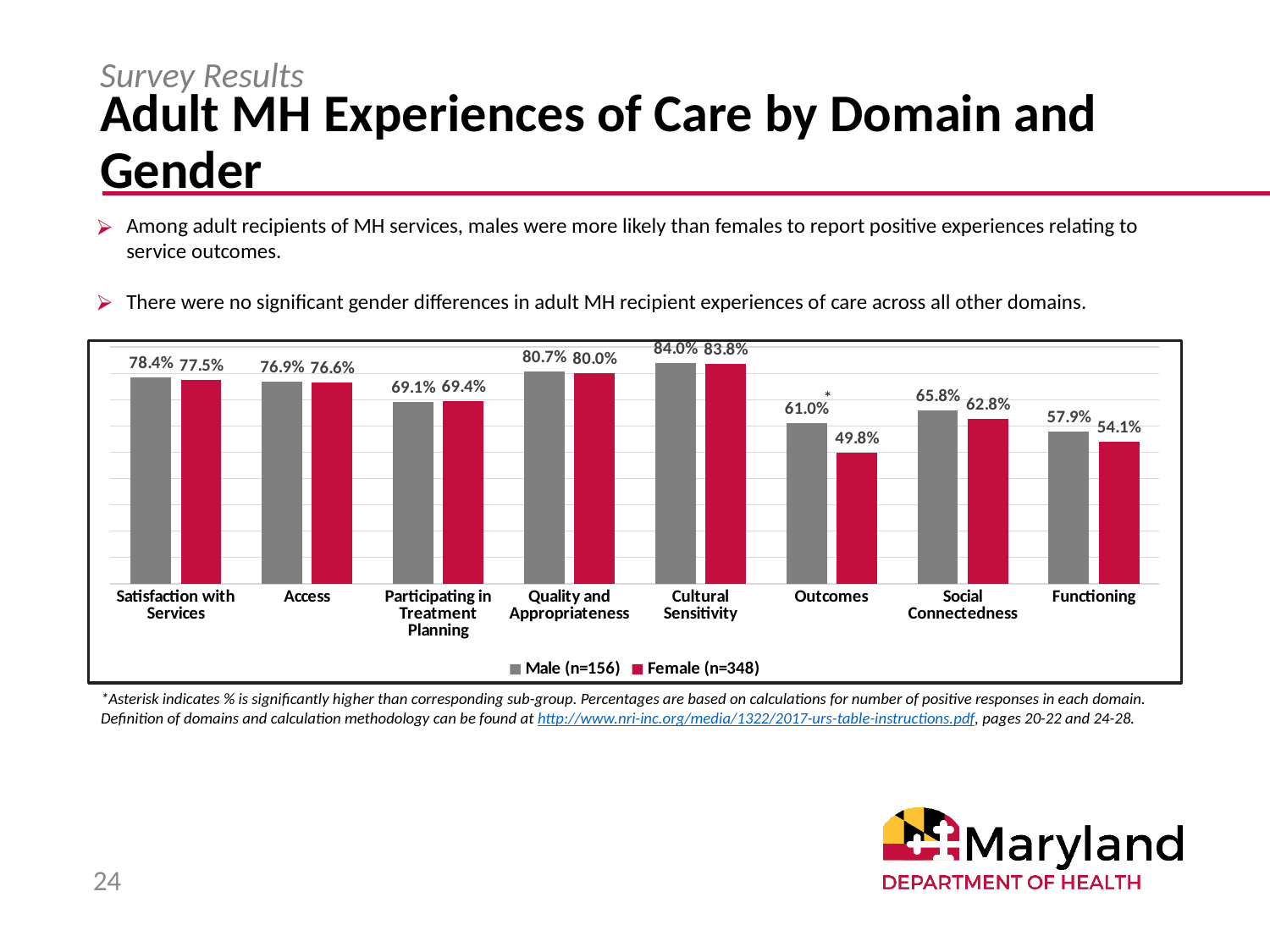
Which domain has the lowest Female (n=348) value? Outcomes How many domains are shown on the x axis of the chart? 8 What kind of chart is shown on the slide? Bar chart What is the Female (n=348) value for Functioning? 54.1% Which is larger for Functioning, the Male (n=156) value or the Female (n=348) value? Male (n=156) What is the difference between the Male and Female values for Outcomes? 11.2% Which domain has the highest Male (n=156) value? Cultural Sensitivity What is the Female (n=348) value for Cultural Sensitivity? 83.8% What is the difference between the Male and Female values for Social Connectedness? 3.0% How many series does the legend list? 2 Which series is shown in red in the chart? Female (n=348) What is the Male (n=156) value for Outcomes? 61.0%